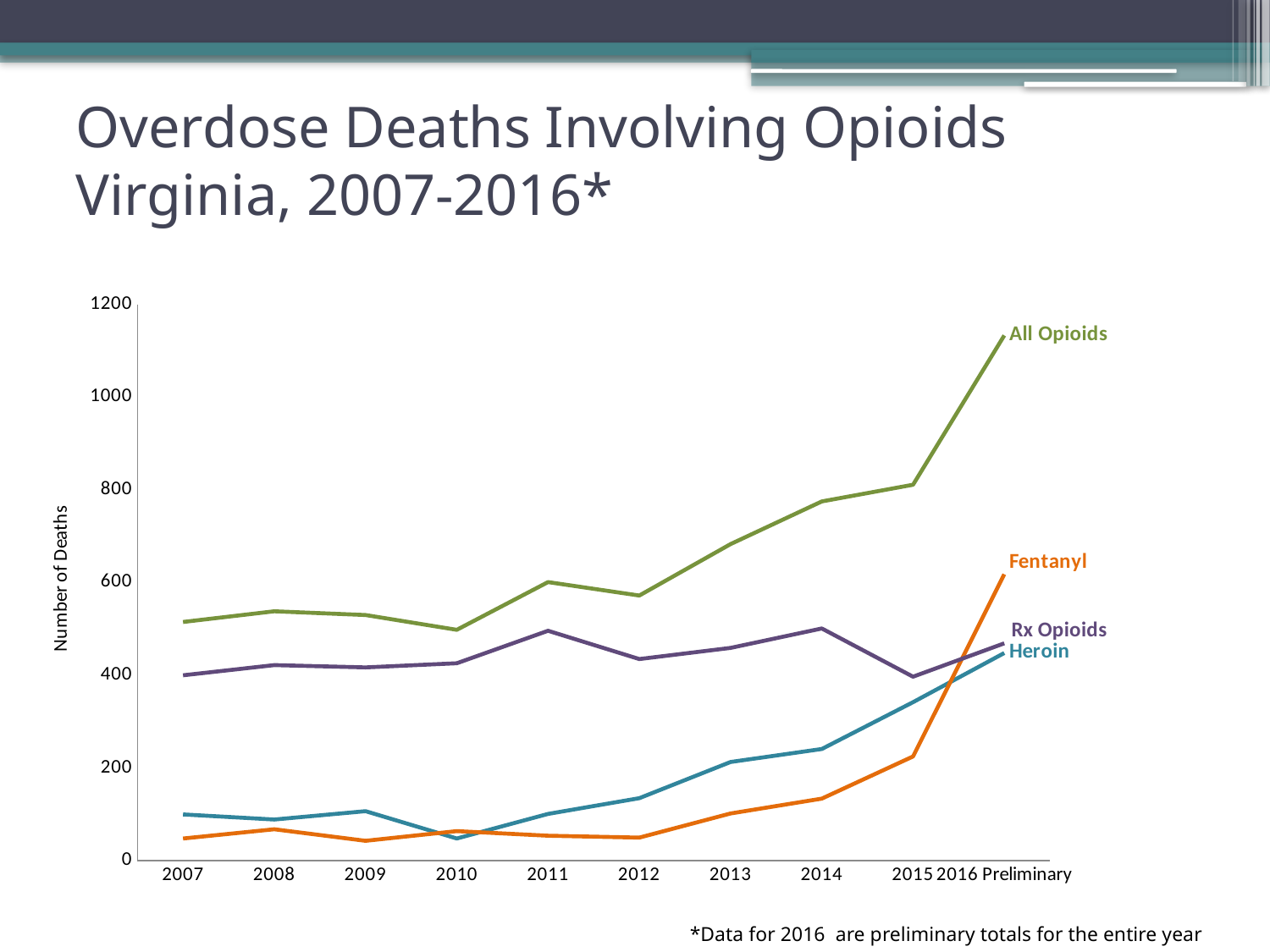
Does the All Opioids line generally rise or fall from 2007 to 2016 Preliminary? Rise What is the label on the vertical axis? Number of Deaths How many years (points) are shown along the x axis? 10 How many series are plotted on the chart? 4 Is the value for Rx Opioids in 2014 greater or less than 400? greater Is the value for Fentanyl in 2007 greater or less than 200? less What kind of chart is shown on the slide? Line chart Is the value for All Opioids in 2016 Preliminary greater or less than 1000? greater Which series has the highest value in 2016 Preliminary? All Opioids In 2016 Preliminary, which is larger: Fentanyl or Heroin? Fentanyl Which series has the lowest value in 2007? Fentanyl